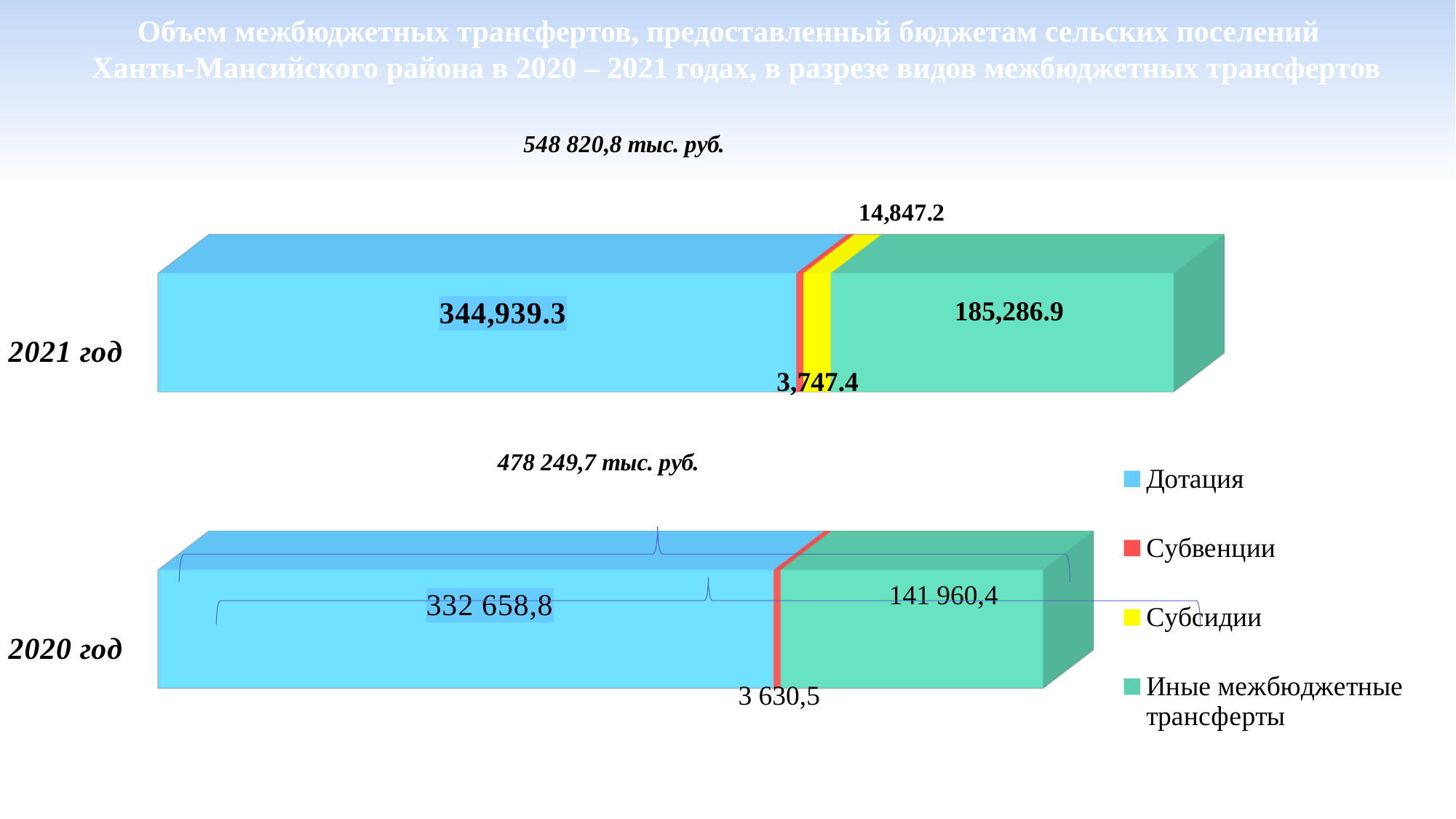
Which is larger: Дотация in 2021 год or Дотация in 2020 год? Дотация in 2021 год What kind of chart is used on this slide? Stacked bar chart What is the total of the 2020 год stacked bar? 478 249,7 тыс. руб. In the 2020 год chart, what is the value for Иные межбюджетные трансферты? 141 960,4 In the 2021 год chart, what is the difference between Дотация and Иные межбюджетные трансферты? 159,652.4 In the 2021 год chart, what is the value for Субвенции? 3,747.4 In the 2020 год chart, what is the value for Субвенции? 3 630,5 In the 2021 год chart, what is the value for Дотация? 344,939.3 In the 2021 год chart, what is the value for Субсидии? 14,847.2 In the 2021 год chart, which transfer type has the smallest value? Субвенции In the 2021 год chart, which transfer type has the largest value? Дотация How many series does the legend list? 4